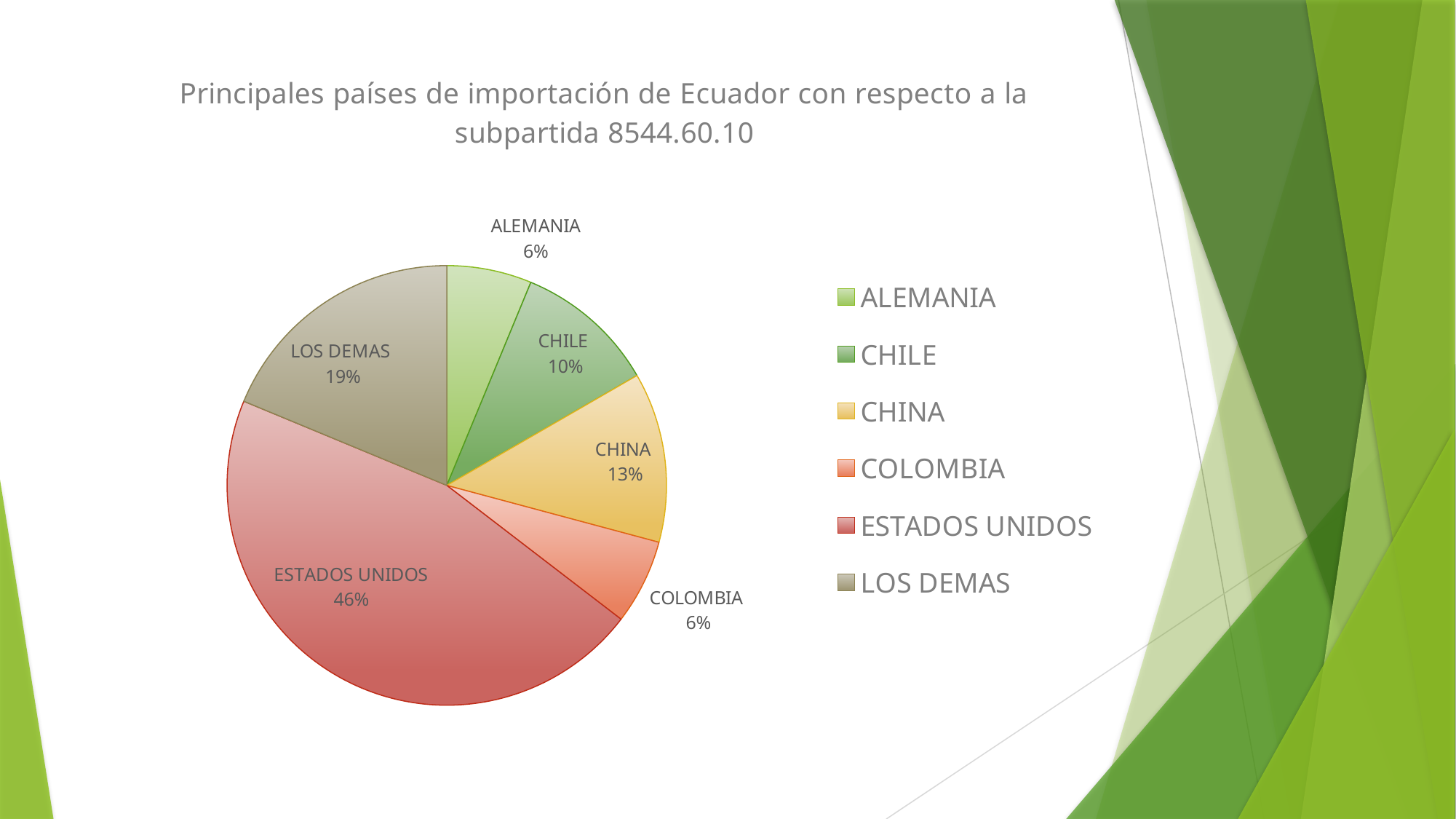
What is the difference in percentage points between CHINA and ALEMANIA? 7 What share of the pie does ESTADOS UNIDOS hold? 46% What is the difference in percentage points between ESTADOS UNIDOS and LOS DEMAS? 27 What percentage is shown for CHILE? 10% What percentage is shown for CHINA? 13% What is the title of the chart? Principales países de importación de Ecuador con respecto a la subpartida 8544.60.10 What percentage is shown for LOS DEMAS? 19% Which slice is larger, CHINA or CHILE? CHINA How many entries does the legend list? 6 What kind of chart is shown on the slide? Pie chart Which country has the largest slice of the pie? ESTADOS UNIDOS How many slices does the pie chart have? 6